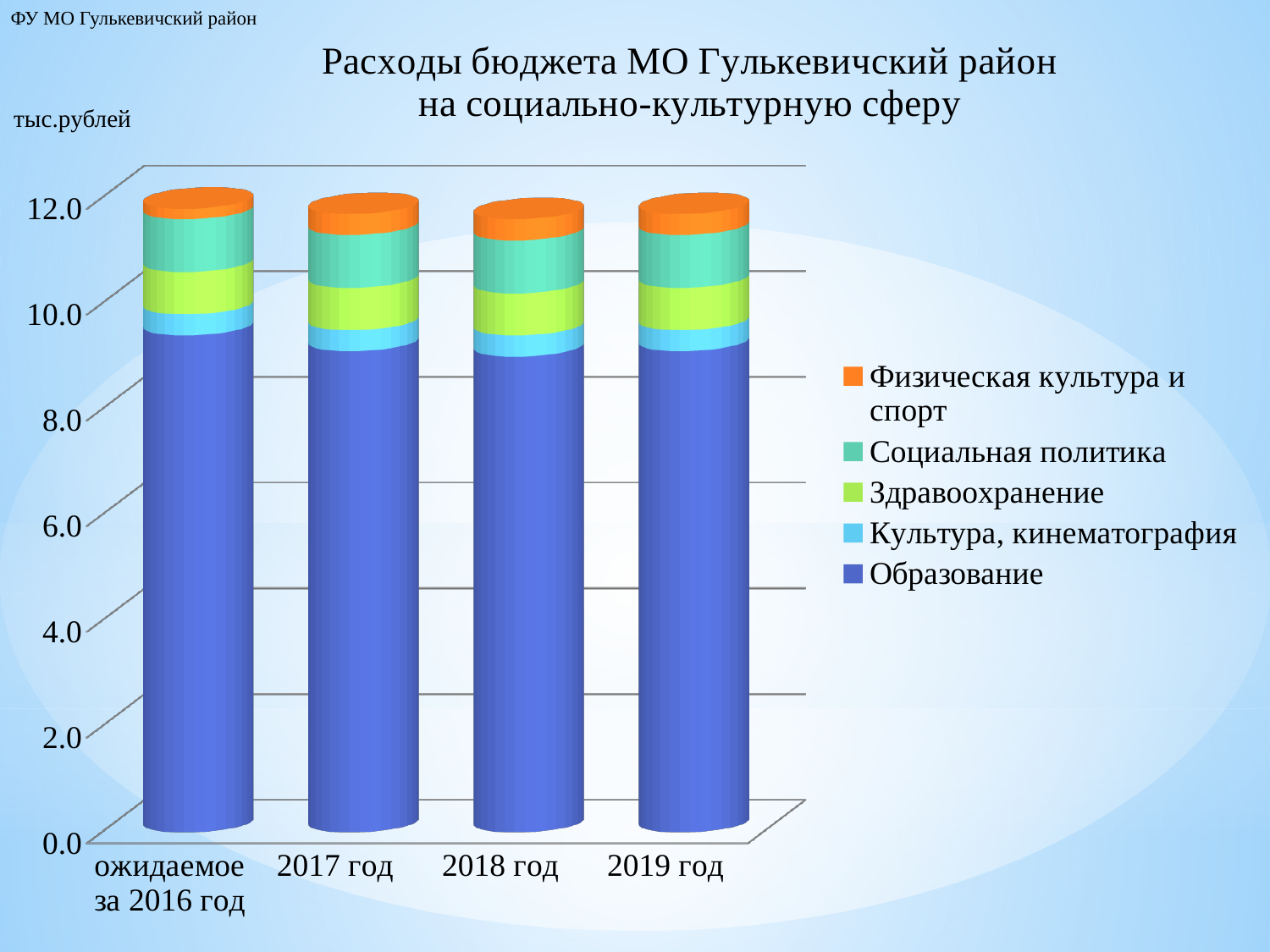
Is the total value of the stacked bar for '2019 год' greater or less than 10.0? greater What unit is shown for the vertical axis? тыс.рублей How many categories (years) are shown on the x axis? 4 In the bar for '2016 год', which segment is larger: 'Образование' or 'Здравоохранение'? Образование Is the total value of the stacked bar for 'ожидаемое за 2016 год' greater or less than 10.0? greater Is the 'Образование' segment for '2017 год' greater or less than 6.0? greater What kind of chart is shown on the slide? stacked bar chart Which series is listed first (at the top) in the legend? Физическая культура и спорт How many series does the legend list? 5